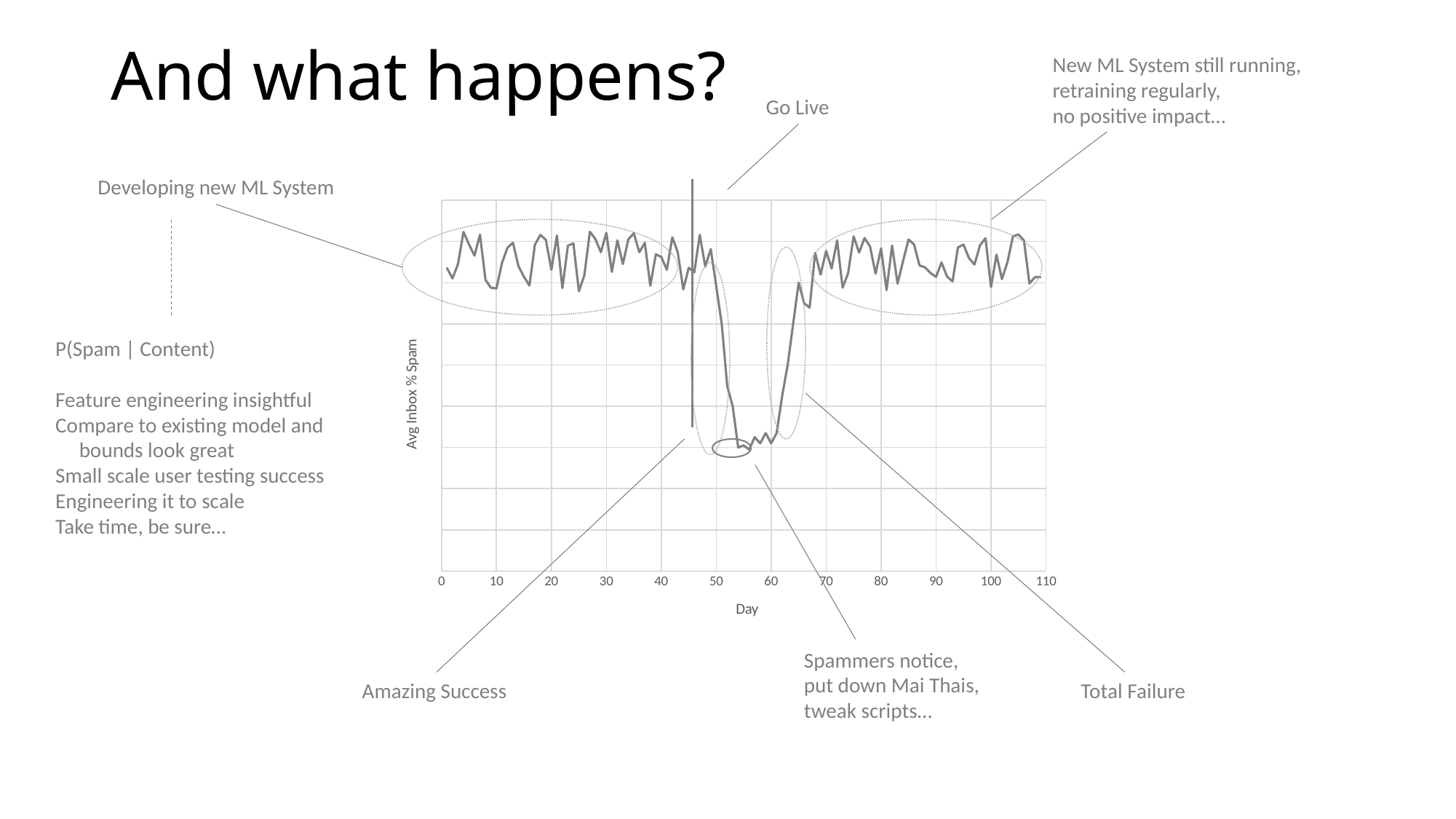
Is the value of the line at day 100 higher or lower than its value at day 55? higher What is the label of the x axis of the chart? Day Does the line return to roughly its pre-drop level after day 70? yes Is the value of the line at day 20 higher or lower than its value at day 58? higher How many tick labels are shown on the x axis of the chart? 12 What kind of chart is shown on the slide? line chart Between day 45 and day 55, does the line rise or fall? fall What is the highest tick value shown on the x axis of the chart? 110 What is the label of the y axis of the chart? Avg Inbox % Spam Between day 60 and day 68, does the line rise or fall? rise Does the lowest part of the line occur before or after day 50? after